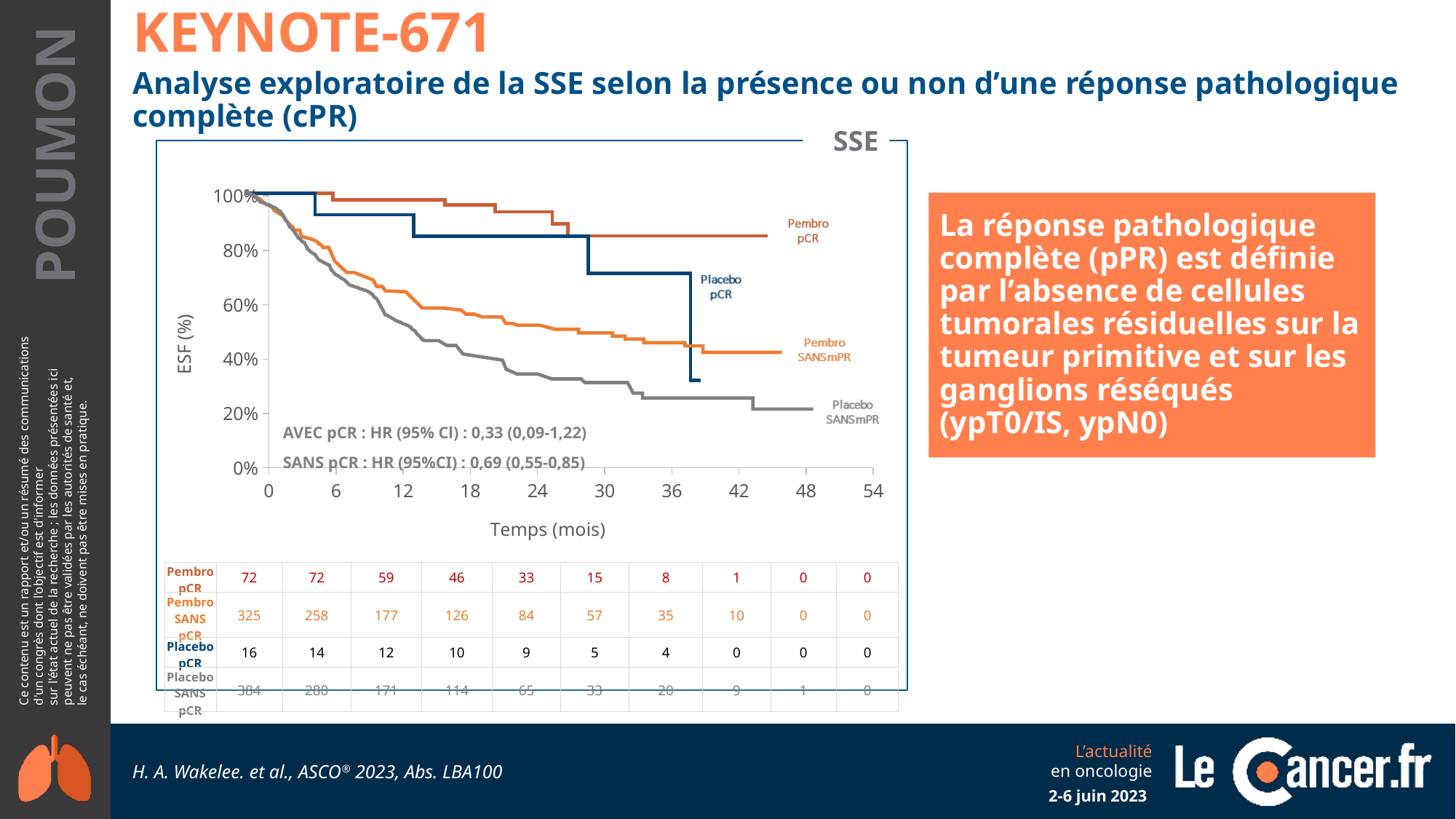
What hazard ratio (95% CI) is printed on the chart for patients SANS pCR? 0,69 (0,55-0,85) What kind of chart is shown on the slide? Line chart (Kaplan-Meier curves) How many curves (groups) are plotted on the SSE chart? 4 Do the curves rise or fall as time (mois) increases? fall According to the number-at-risk table, which group had the largest number of patients at risk at time 0? Placebo SANS pCR What hazard ratio (95% CI) is printed on the chart for patients AVEC pCR? 0,33 (0,09-1,22) Is the value of the Placebo pCR curve at 30 months greater or less than 60%? greater According to the number-at-risk table, how many Pembro pCR patients were at risk at time 0? 72 Is the value of the Pembro pCR curve at 24 months greater or less than 80%? greater What is the label of the x axis of the SSE chart? Temps (mois) What is the label of the y axis of the SSE chart? ESF (%) Is the value of the Placebo SANS pCR curve at 24 months greater or less than 40%? less